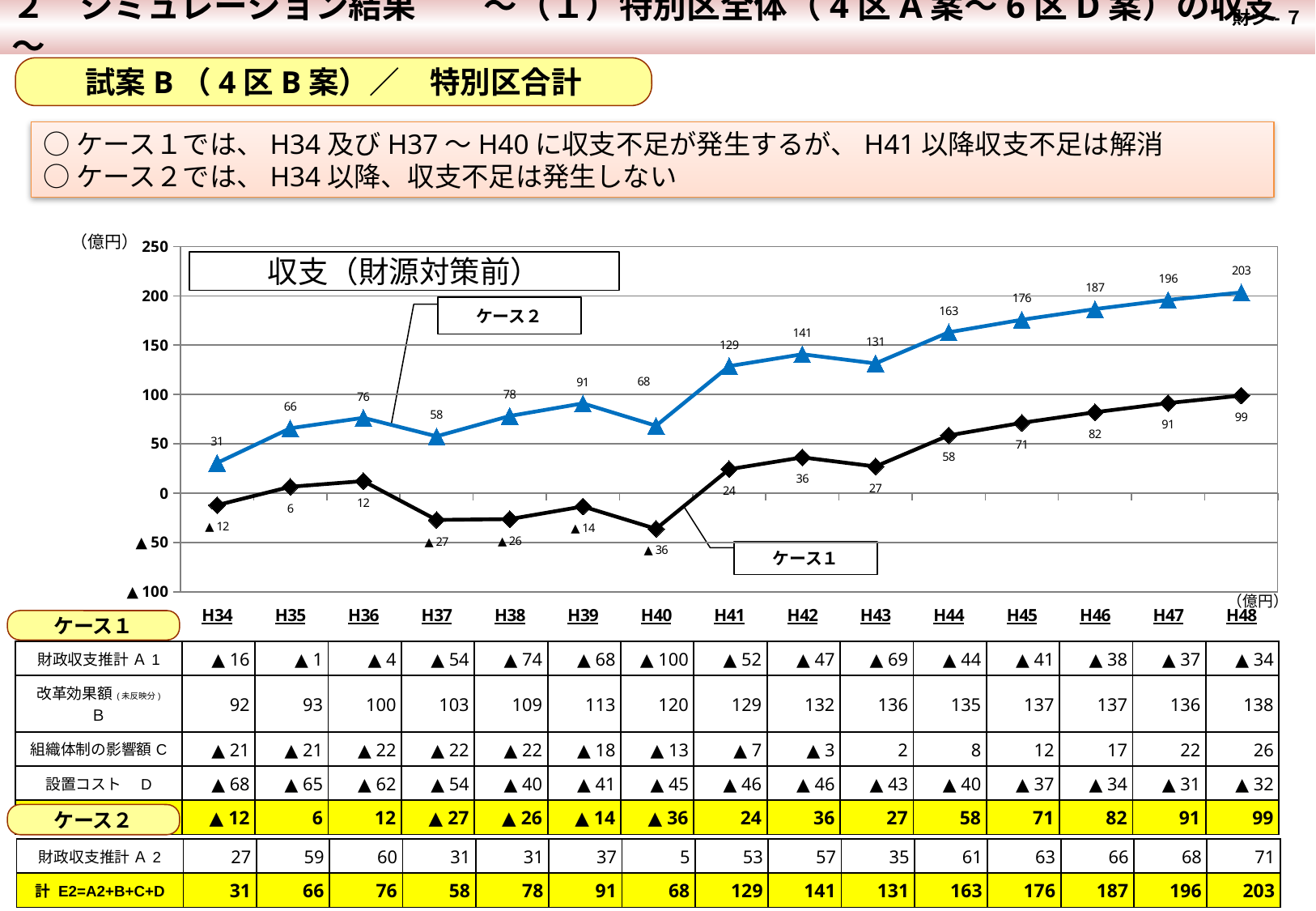
What kind of chart is shown? line chart Which is larger at H44: ケース1 or ケース2? ケース2 What is the difference between ケース2 and ケース1 at H48? 104 What is the value of ケース1 at H48? 99 What is the value of ケース2 at H42? 141 How many years are plotted on the x axis? 15 At which year is ケース1 at its lowest value? H40 How many series are plotted in the chart? 2 What is the title shown inside the chart? 収支（財源対策前） At which year does ケース2 reach its highest value? H48 Is the value for ケース2 at H41 greater or less than 100? greater What is the value of ケース1 at H40? ▲36